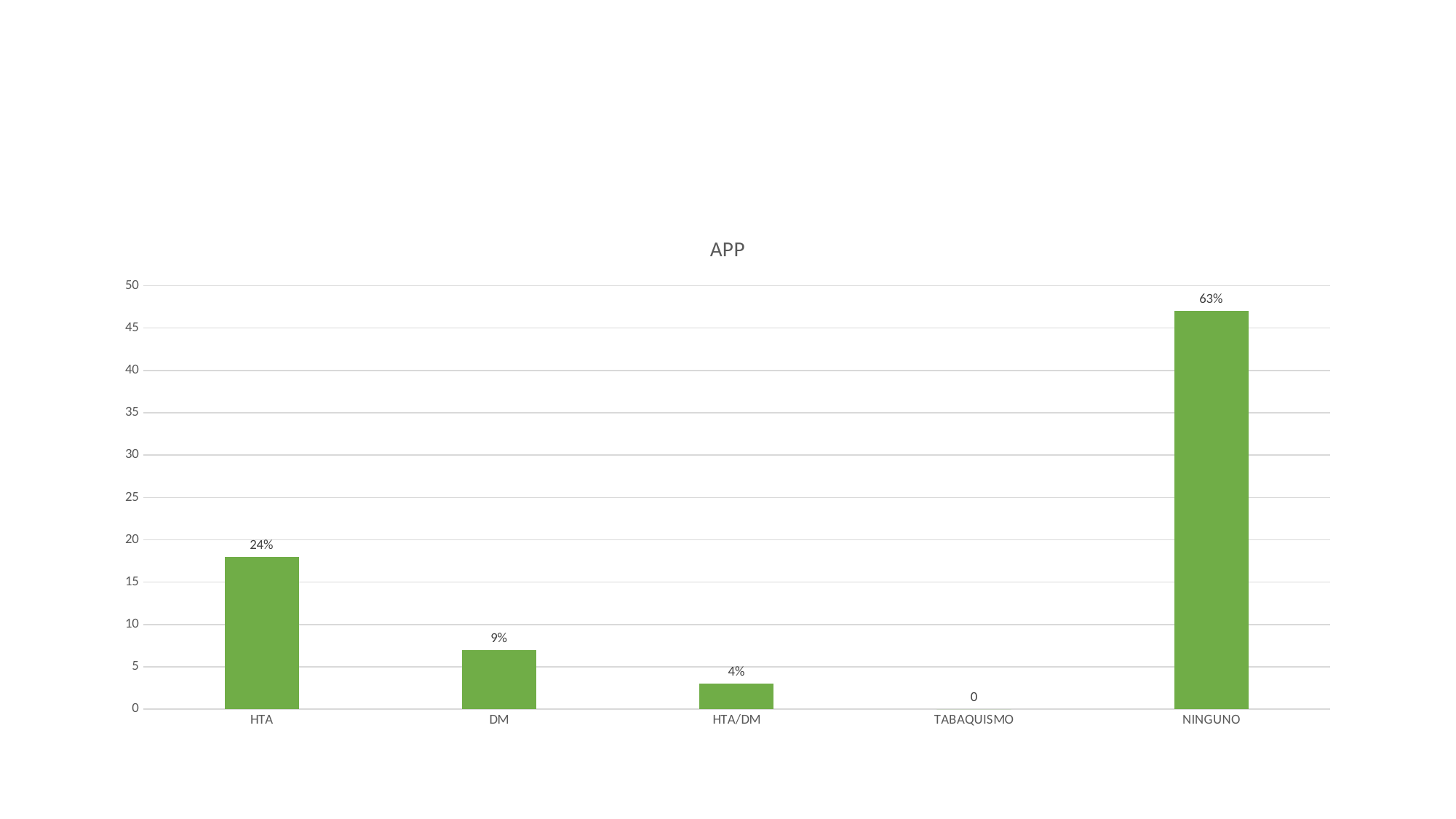
What is the data label shown for HTA/DM? 4% What is the data label shown for NINGUNO? 63% What is the data label shown for DM? 9% Which category has the highest bar? NINGUNO What is the title of the chart? APP How many categories are shown on the x axis? 5 Which category has the lowest value? TABAQUISMO What is the data label shown for TABAQUISMO? 0 Is the bar for HTA greater or less than 20 on the vertical axis? less Is the bar for NINGUNO greater or less than 45 on the vertical axis? greater What is the data label shown for HTA? 24% Which is larger, the bar for HTA or the bar for DM? HTA